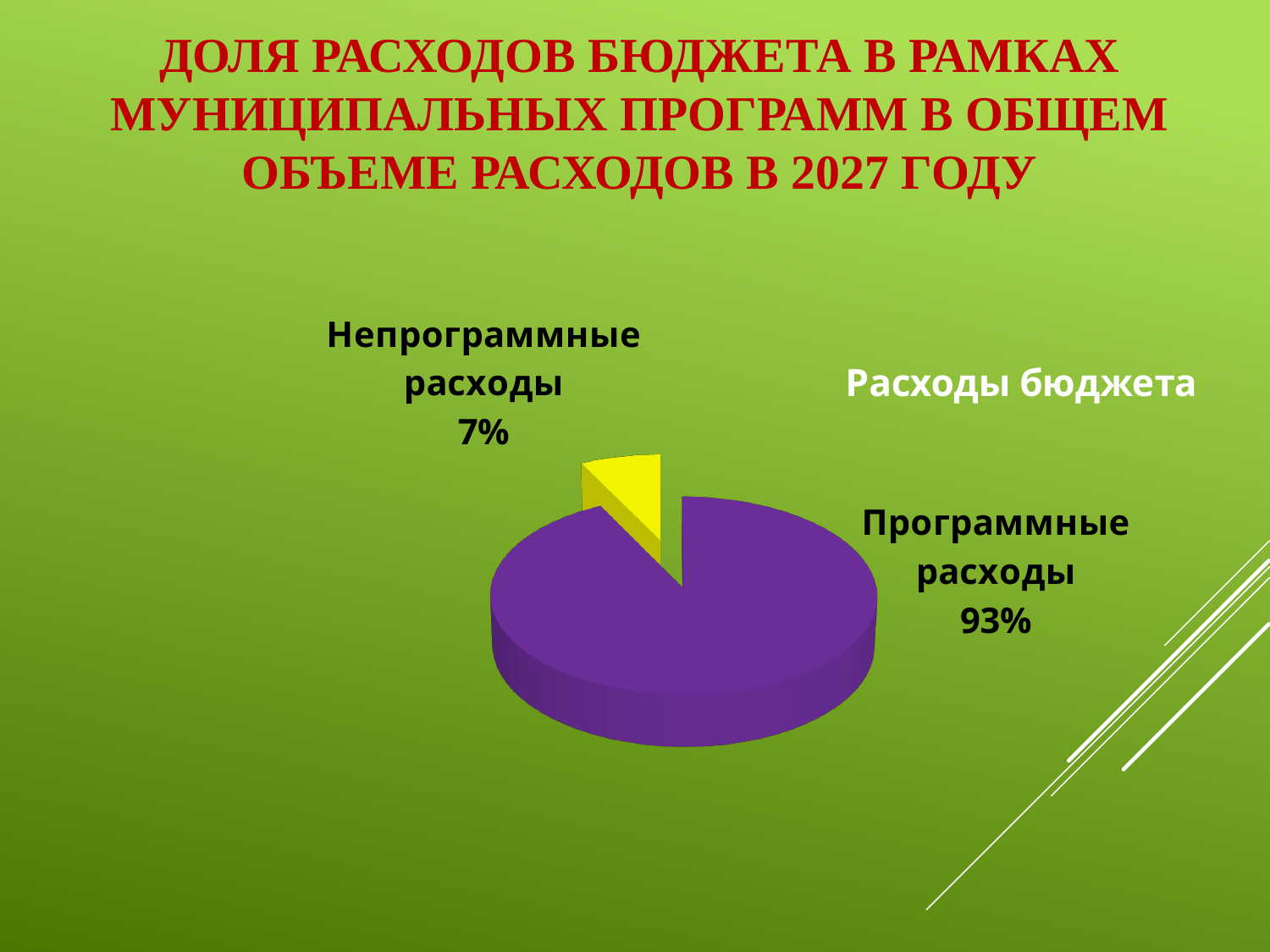
What is the total of the two slices shown in the pie chart? 100% What kind of chart is shown on the slide? pie chart How many slices does the pie chart have? 2 What is the difference in percentage points between Программные расходы and Непрограммные расходы? 86 What share of the pie is labelled Программные расходы? 93% Which is larger, Программные расходы or Непрограммные расходы? Программные расходы Which slice of the pie is the largest? Программные расходы What share of the pie is labelled Непрограммные расходы? 7% Which slice of the pie is the smallest? Непрограммные расходы What is the title of the chart? Расходы бюджета What colour is the slice for Непрограммные расходы? yellow